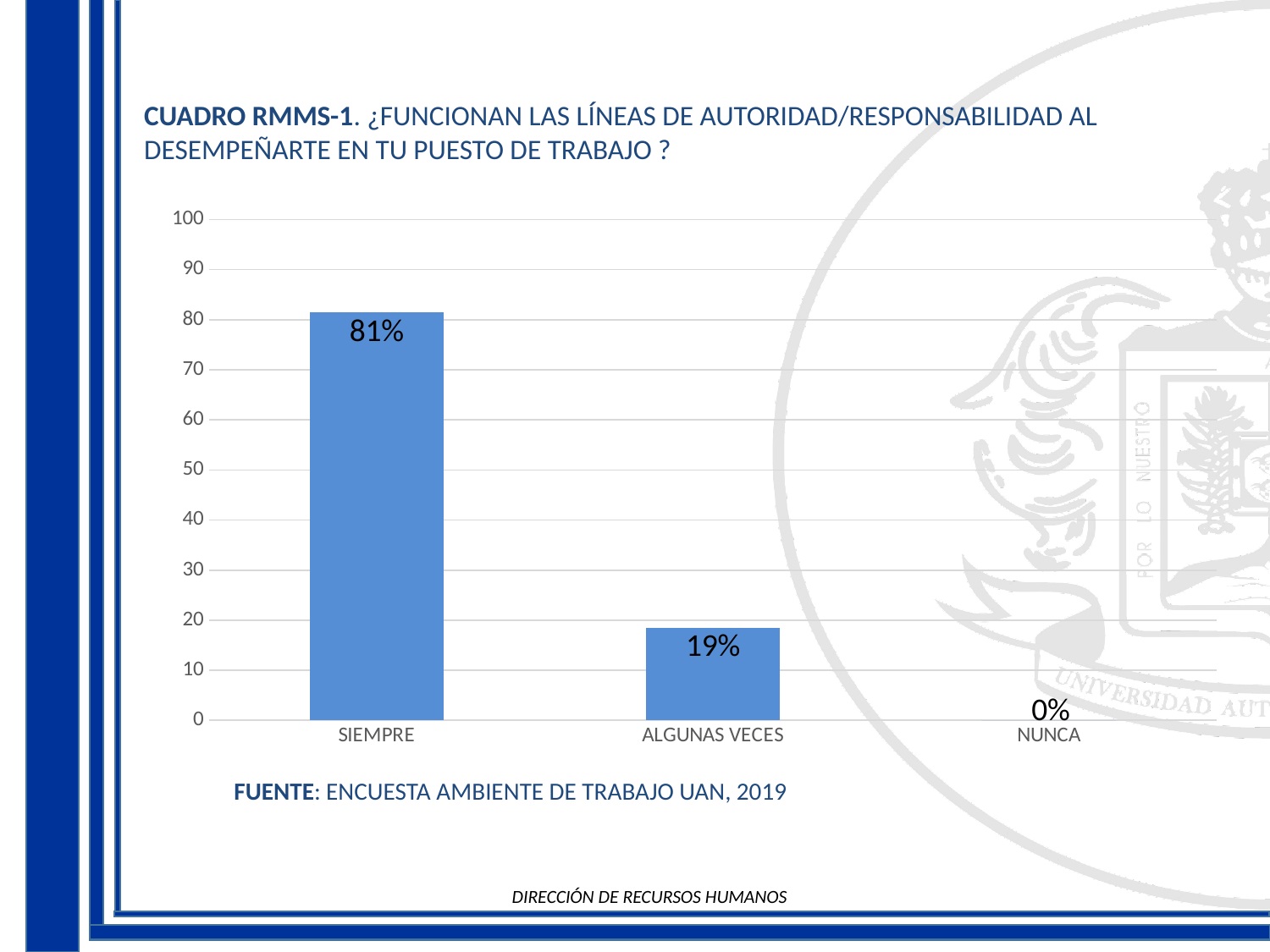
What is the difference between the values for SIEMPRE and ALGUNAS VECES? 62% What kind of chart is shown on the slide? bar chart How many categories are shown on the x axis? 3 What source is cited below the chart? ENCUESTA AMBIENTE DE TRABAJO UAN, 2019 Is the value for ALGUNAS VECES greater or less than 30? less Which category has the highest value? SIEMPRE What is the value for ALGUNAS VECES? 19% What is the value for SIEMPRE? 81% Is the value for SIEMPRE greater or less than 70? greater What is the value for NUNCA? 0% Which is larger, the value for ALGUNAS VECES or the value for NUNCA? ALGUNAS VECES Which category has the lowest value? NUNCA